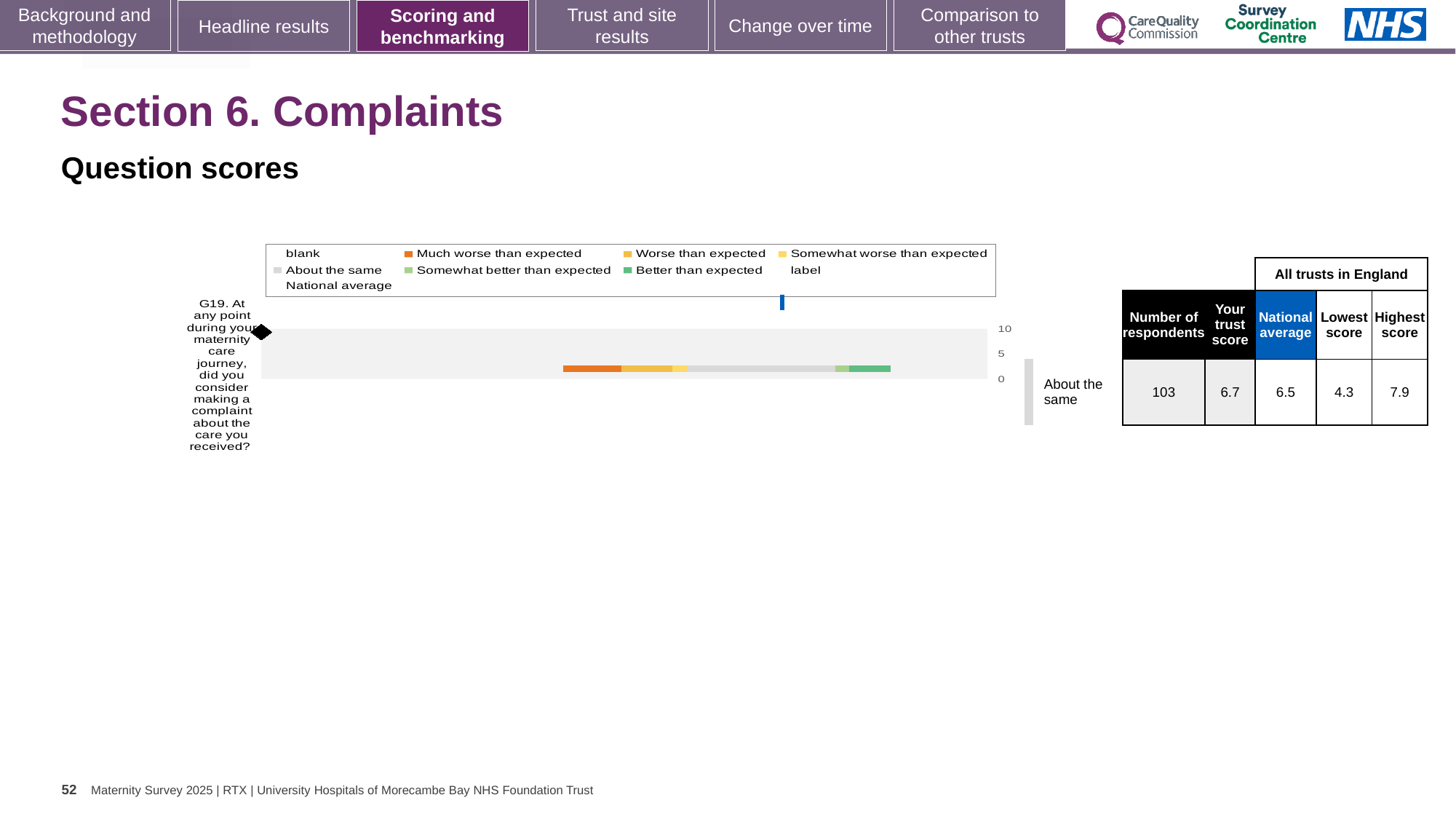
What benchmark rating is shown for question G19 next to the chart? About the same In the table beside the chart, what is the trust score for question G19? 6.7 Which question is plotted in the chart? G19. At any point during your maternity care journey, did you consider making a complaint about the care you received? In the table beside the chart, what is the number of respondents for question G19? 103 In the table beside the chart, what is the highest score among all trusts in England for question G19? 7.9 How many questions (categories) are plotted in the chart? 1 What is the difference between the highest score and the lowest score for question G19 in the table beside the chart? 3.6 Which legend entry is shown in orange? Much worse than expected Is the trust score for question G19 higher or lower than the national average? higher In the table beside the chart, what is the national average for question G19? 6.5 In the table beside the chart, what is the lowest score among all trusts in England for question G19? 4.3 What kind of chart is shown on the slide? bar chart